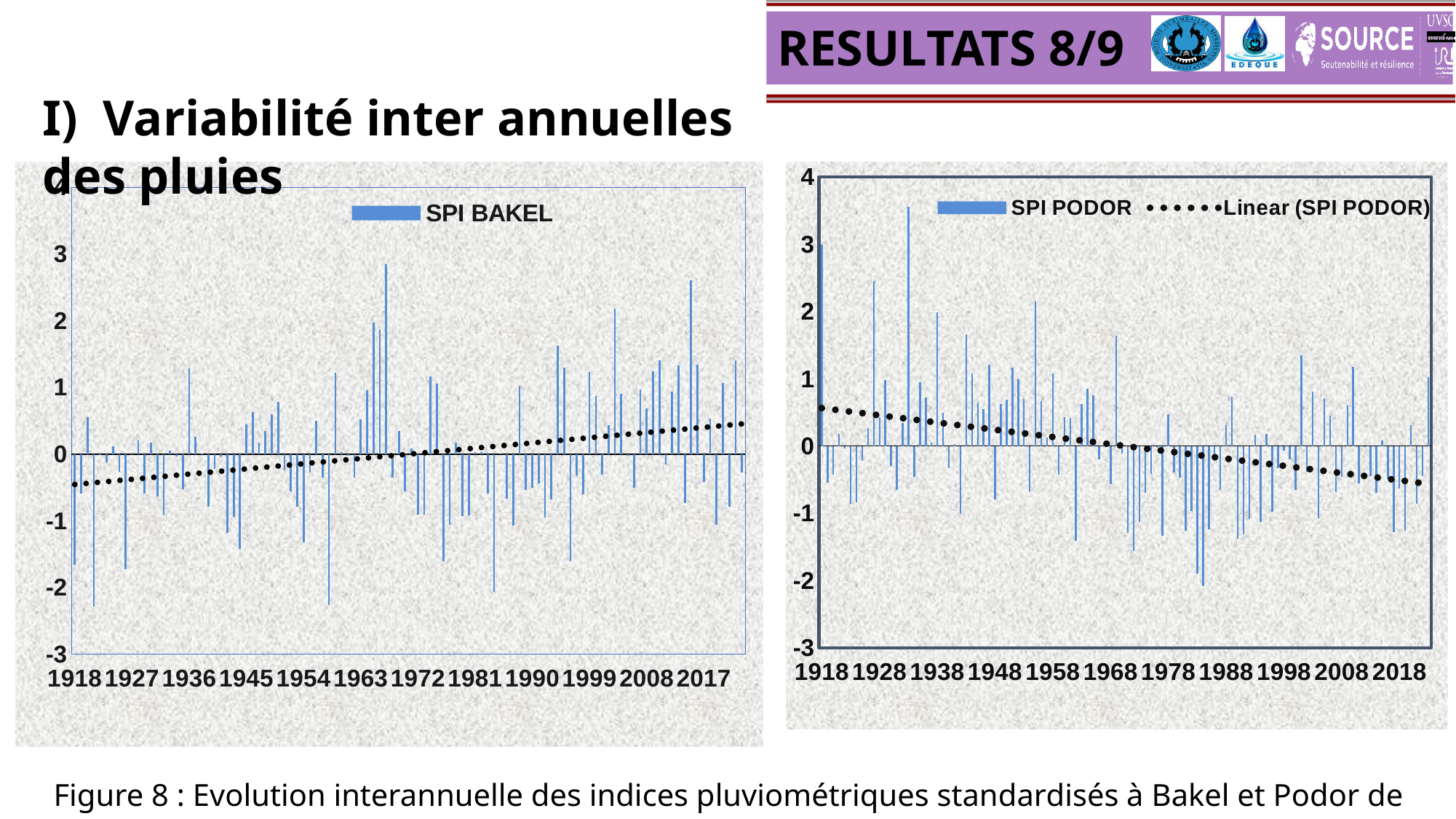
In the SPI BAKEL chart on the left, does the dotted trend line rise or fall from 1918 to 2017? rise In the SPI PODOR chart on the right, does the dotted linear trend line rise or fall from 1918 to 2018? fall What is the name of the trend line series in the legend of the SPI PODOR chart on the right? Linear (SPI PODOR) In the SPI PODOR chart on the right, is the tallest bar greater or less than 3? greater How many series does the legend of the SPI PODOR chart on the right list? 2 How many series does the legend of the SPI BAKEL chart on the left list? 1 In the SPI BAKEL chart on the left, is the value for 1918 greater or less than -1? less In the SPI BAKEL chart on the left, is the tallest bar greater or less than 2? greater What kind of chart is the SPI PODOR chart on the right? bar chart What kind of chart is the SPI BAKEL chart on the left? bar chart What is the highest value shown on the vertical axis of the SPI PODOR chart on the right? 4